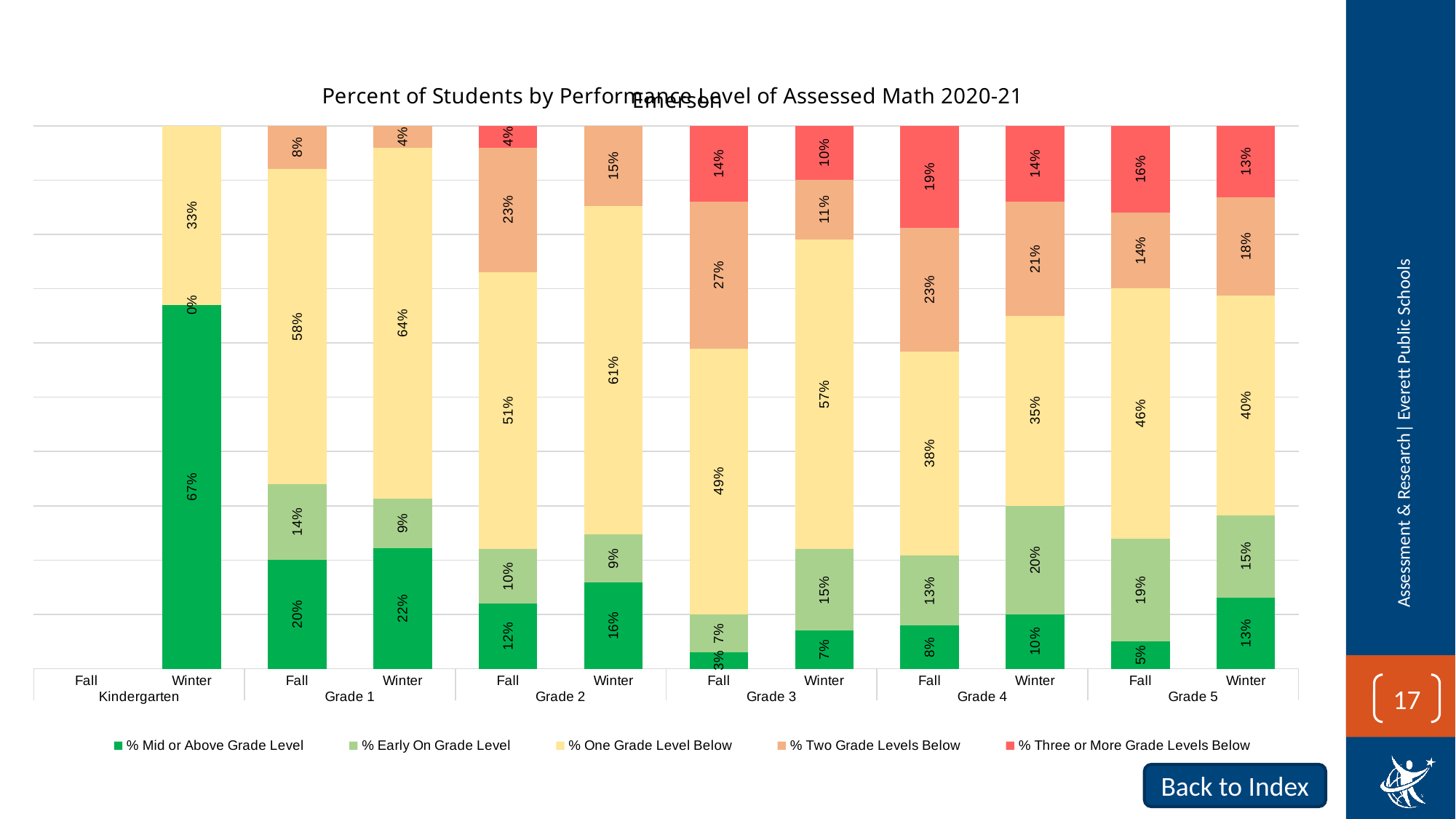
How many series does the legend list? 5 Which bar has the lowest percentage of students Mid or Above Grade Level? Grade 3 Fall What is the combined percentage of Grade 2 Winter students who were Mid or Above Grade Level or Early On Grade Level? 25% What kind of chart is shown on the slide? Stacked bar chart What percentage of Kindergarten Winter students were Early On Grade Level? 0% Which is larger: the Two Grade Levels Below percentage for Grade 3 Fall or for Grade 4 Fall? Grade 3 Fall What percentage of Grade 4 Fall students were Three or More Grade Levels Below? 19% Which bar has the highest percentage of students Mid or Above Grade Level? Kindergarten Winter What percentage of Grade 1 Winter students were One Grade Level Below? 64% Which colour represents % Three or More Grade Levels Below in the legend? Red What is the difference between the Mid or Above Grade Level percentages for Grade 5 Winter and Grade 5 Fall? 8% What percentage of Grade 3 Fall students were Mid or Above Grade Level? 3%